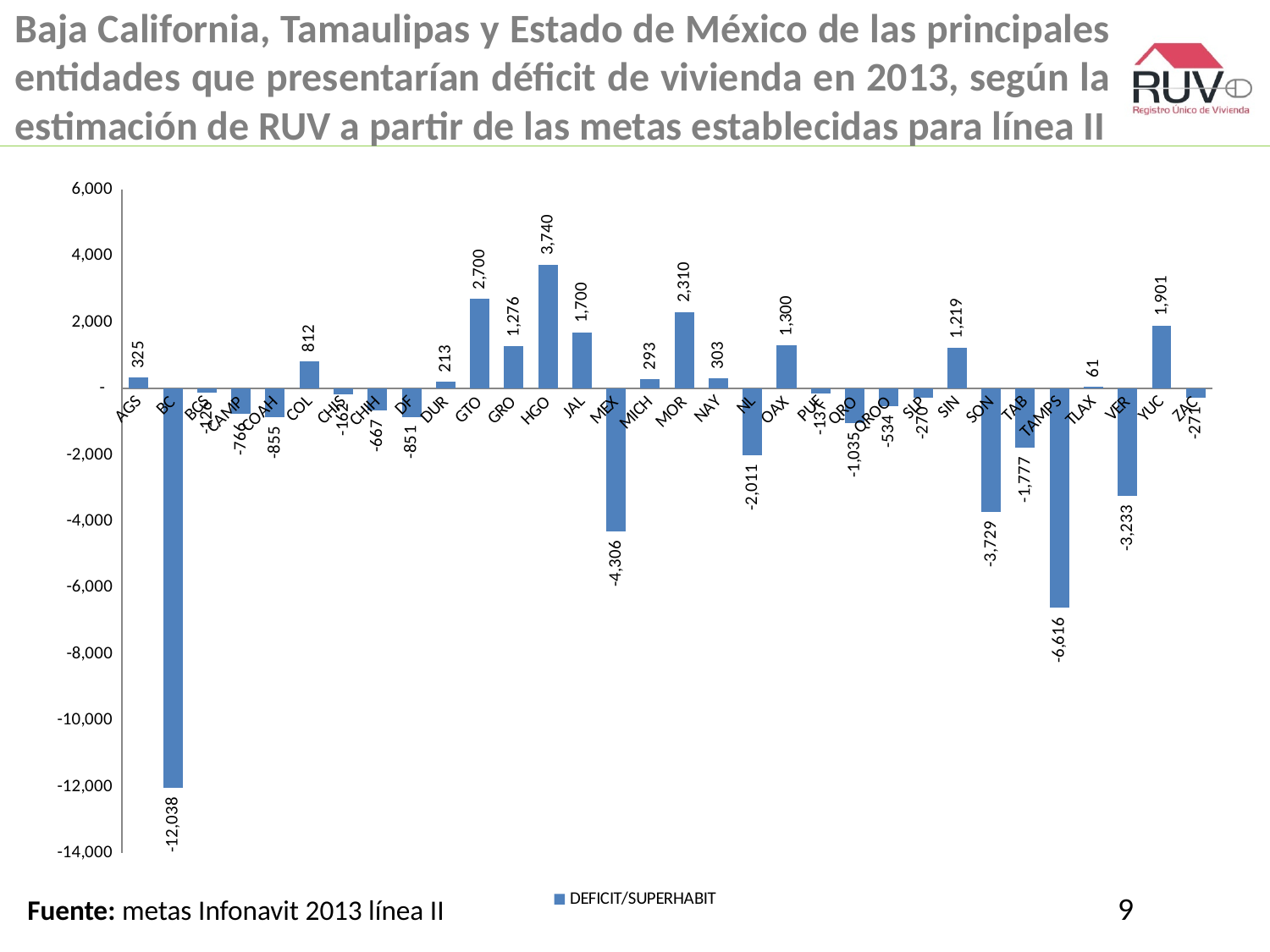
What is the value for BC? -12,038 How many entities are shown on the x axis? 32 Is the value for SON greater or less than -2,000? less What is the value for TAMPS? -6,616 Which entity has the lowest value? BC What is the value for MEX? -4,306 What kind of chart is shown? bar chart How many series does the legend list? 1 What is the value for HGO? 3,740 What is the difference between the values for GTO and MOR? 390 Which entity has the highest value? HGO Which is larger, the value for YUC or the value for JAL? YUC